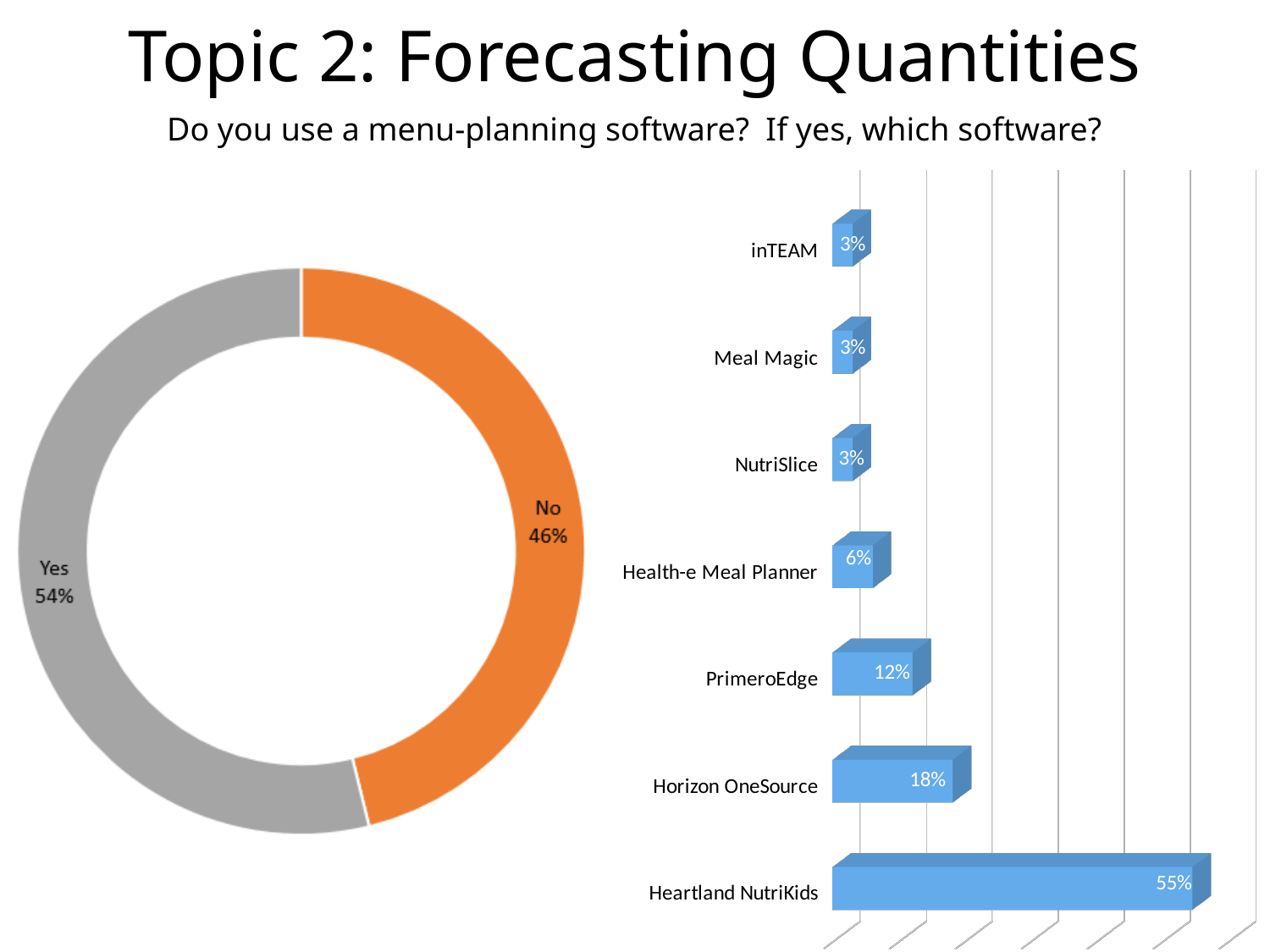
In the doughnut chart on the left, which answer has the larger share, Yes or No? Yes What type of chart is shown on the right side of the slide? Bar chart In the doughnut chart on the left, how many slices are there? 2 In the bar chart on the right, what is the value for Health-e Meal Planner? 6% In the doughnut chart on the left, what percentage of respondents answered Yes? 54% In the bar chart on the right, which software has the highest value? Heartland NutriKids In the bar chart on the right, what is the value for Horizon OneSource? 18% In the bar chart on the right, how many software categories are listed? 7 In the doughnut chart on the left, what percentage of respondents answered No? 46% In the bar chart on the right, which is larger, PrimeroEdge or Health-e Meal Planner? PrimeroEdge In the bar chart on the right, what is the difference between Heartland NutriKids and Horizon OneSource? 37% In the bar chart on the right, what is the value for Heartland NutriKids? 55%